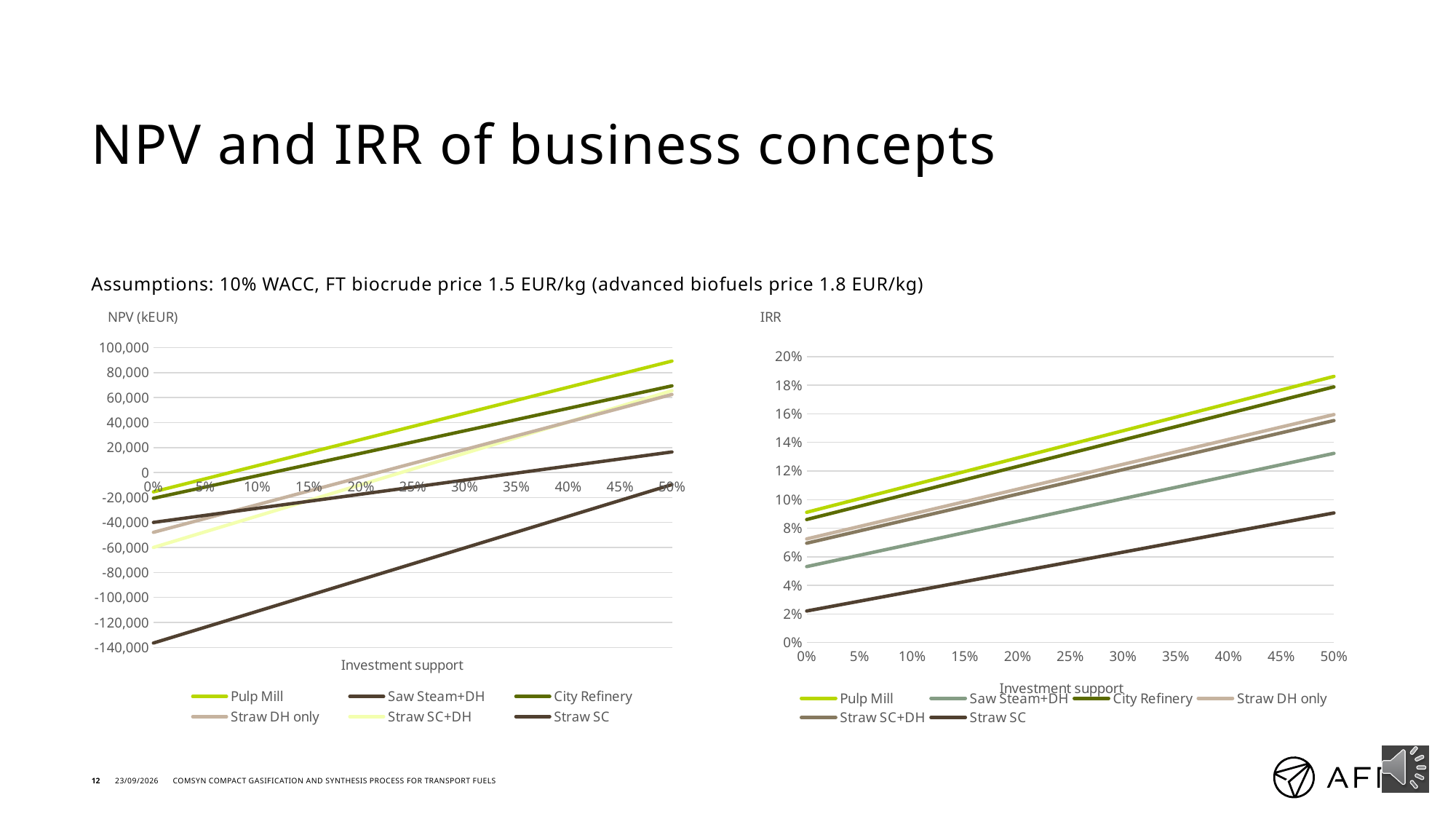
How many series does the legend of the IRR chart list? 6 In the NPV (kEUR) chart, does the Pulp Mill line rise or fall as investment support increases? Rise In the NPV (kEUR) chart, which series has the highest value at 50% investment support? Pulp Mill In the NPV (kEUR) chart, which series has the lowest value at 0% investment support? Straw SC In the IRR chart, which series has the lowest value at 0% investment support? Straw SC In the NPV (kEUR) chart, is the value for Saw Steam+DH at 0% investment support greater or less than -120,000? greater In the IRR chart, is the value for Saw Steam+DH at 50% investment support greater or less than 12%? greater What kind of chart is the NPV (kEUR) chart on the left? Line chart How many investment support levels are marked on the x axis of the IRR chart? 11 What is the x-axis title of the IRR chart? Investment support In the NPV (kEUR) chart, is the value for Pulp Mill at 50% investment support greater or less than 80,000? greater In the IRR chart, which is larger at 50% investment support, Pulp Mill or Straw SC? Pulp Mill